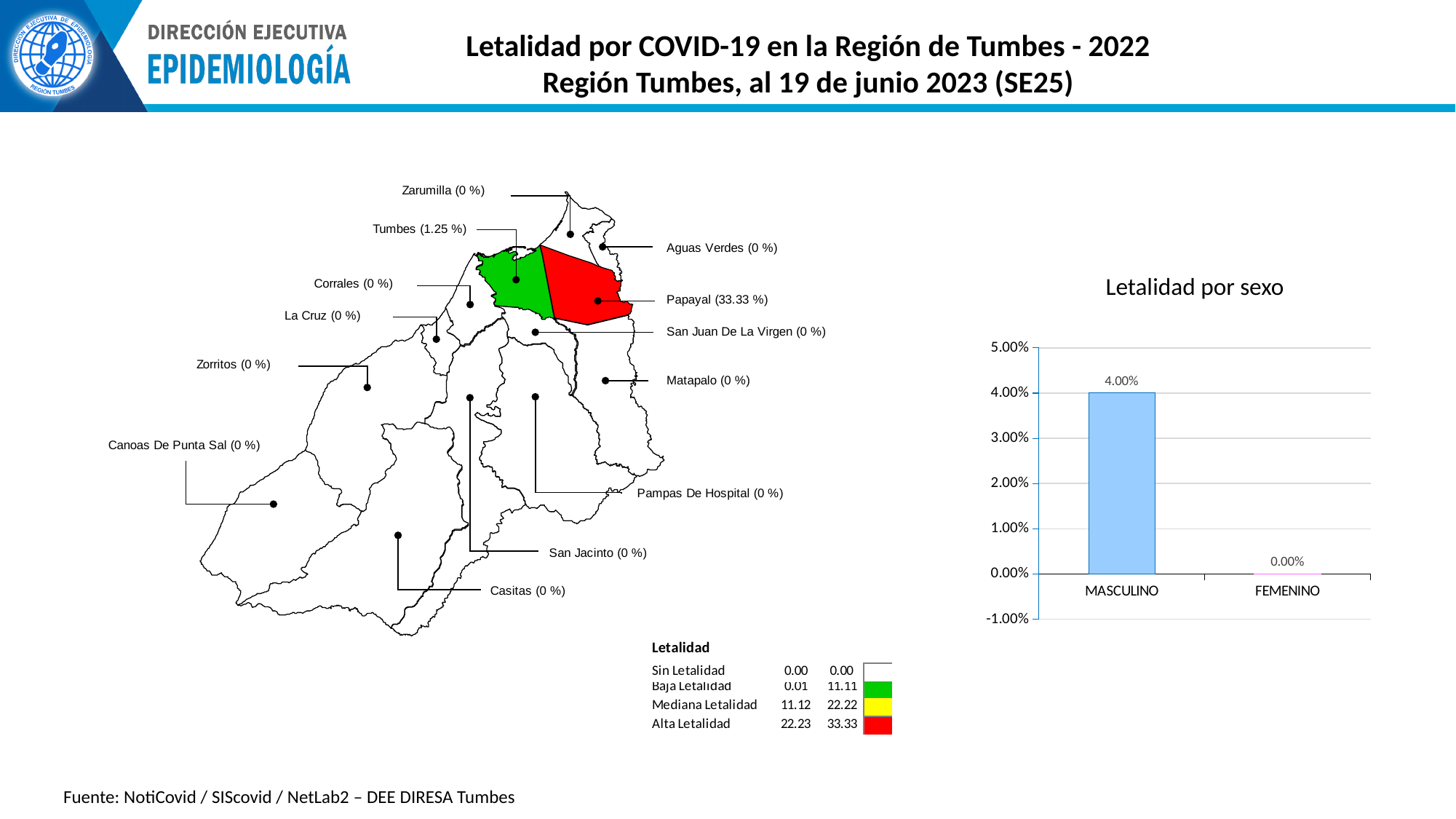
On the map of the Tumbes region, what is the lethality value shown for Tumbes? 1.25 % In the 'Letalidad por sexo' chart, what is the difference between the MASCULINO and FEMENINO values? 4.00% In the 'Letalidad por sexo' chart, which category has the lowest value? FEMENINO What kind of chart is 'Letalidad por sexo'? bar chart In the 'Letalidad por sexo' chart, what is the value for MASCULINO? 4.00% In the 'Letalidad por sexo' chart, what is the value for FEMENINO? 0.00% In the 'Letalidad por sexo' chart, is the value for MASCULINO greater or less than 3.00%? greater What is the highest value shown on the y axis of the 'Letalidad por sexo' chart? 5.00% What is the title of the bar chart on the right side of the slide? Letalidad por sexo On the map of the Tumbes region, what is the lethality value shown for Papayal? 33.33 % In the 'Letalidad por sexo' chart, which category has the highest value? MASCULINO How many categories are shown on the x axis of the 'Letalidad por sexo' chart? 2